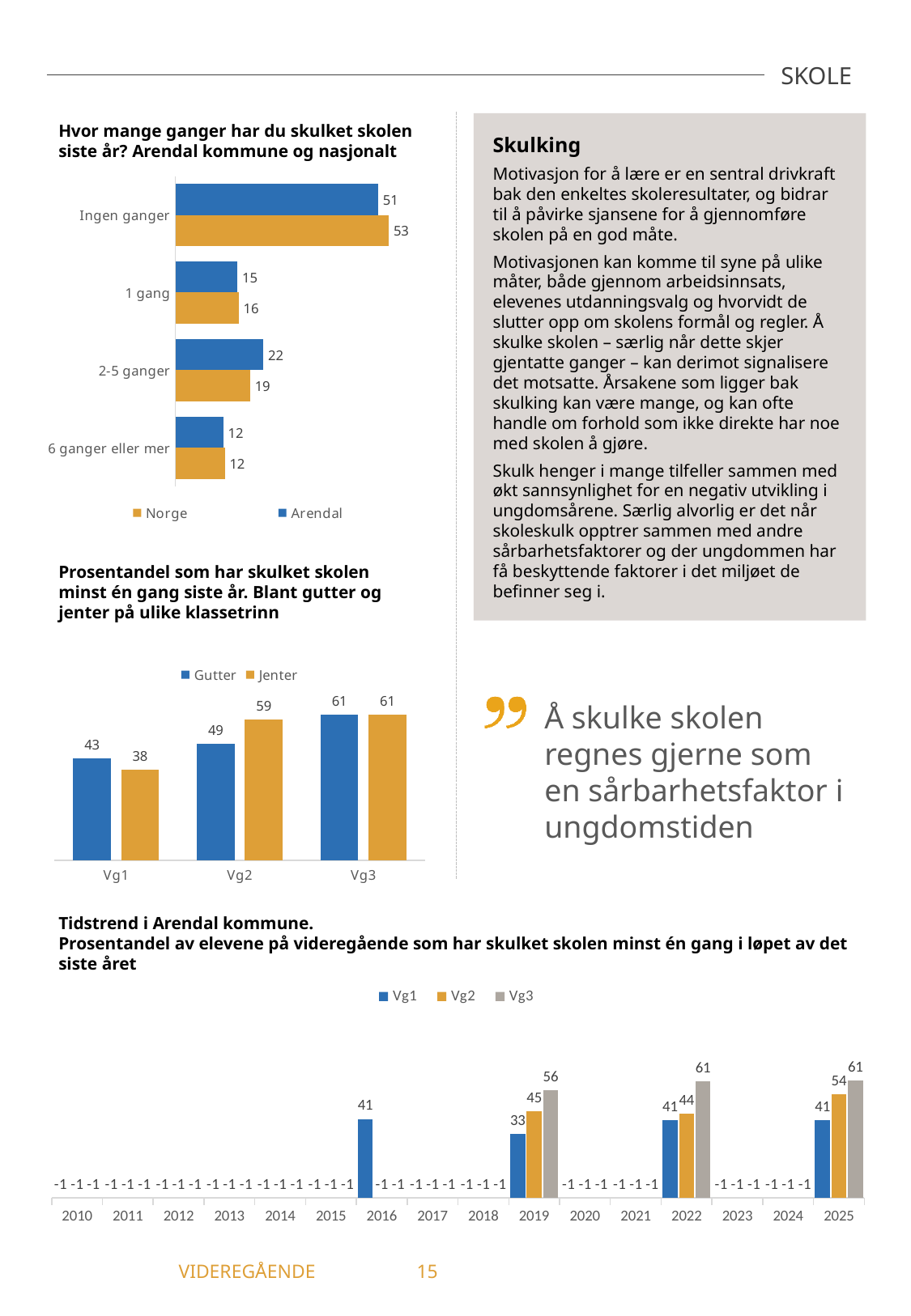
In the chart 'Hvor mange ganger har du skulket skolen siste år?', what is the difference between Norge and Arendal for 'Ingen ganger'? 2 In the chart 'Prosentandel som har skulket skolen minst én gang siste år', how many categories are shown on the x axis? 3 In the chart 'Tidstrend i Arendal kommune', does the Vg2 value rise or fall from 2019 to 2025? Rise In the chart 'Hvor mange ganger har du skulket skolen siste år?', how many series does the legend list? 2 In the chart 'Hvor mange ganger har du skulket skolen siste år?', which category has the highest value for Norge? Ingen ganger In the chart 'Prosentandel som har skulket skolen minst én gang siste år', what is the value for Jenter at Vg2? 59 In the chart 'Prosentandel som har skulket skolen minst én gang siste år', which is larger at Vg1, Gutter or Jenter? Gutter In the chart 'Tidstrend i Arendal kommune', what is the difference between Vg3 and Vg1 in 2025? 20 In the chart 'Prosentandel som har skulket skolen minst én gang siste år', what kind of chart is it? Bar chart In the chart 'Tidstrend i Arendal kommune', what is the value for Vg3 in 2019? 56 In the chart 'Hvor mange ganger har du skulket skolen siste år?', what is the value for Arendal in the category 'Ingen ganger'? 51 In the chart 'Hvor mange ganger har du skulket skolen siste år?', what is the value for Norge in the category '2-5 ganger'? 19